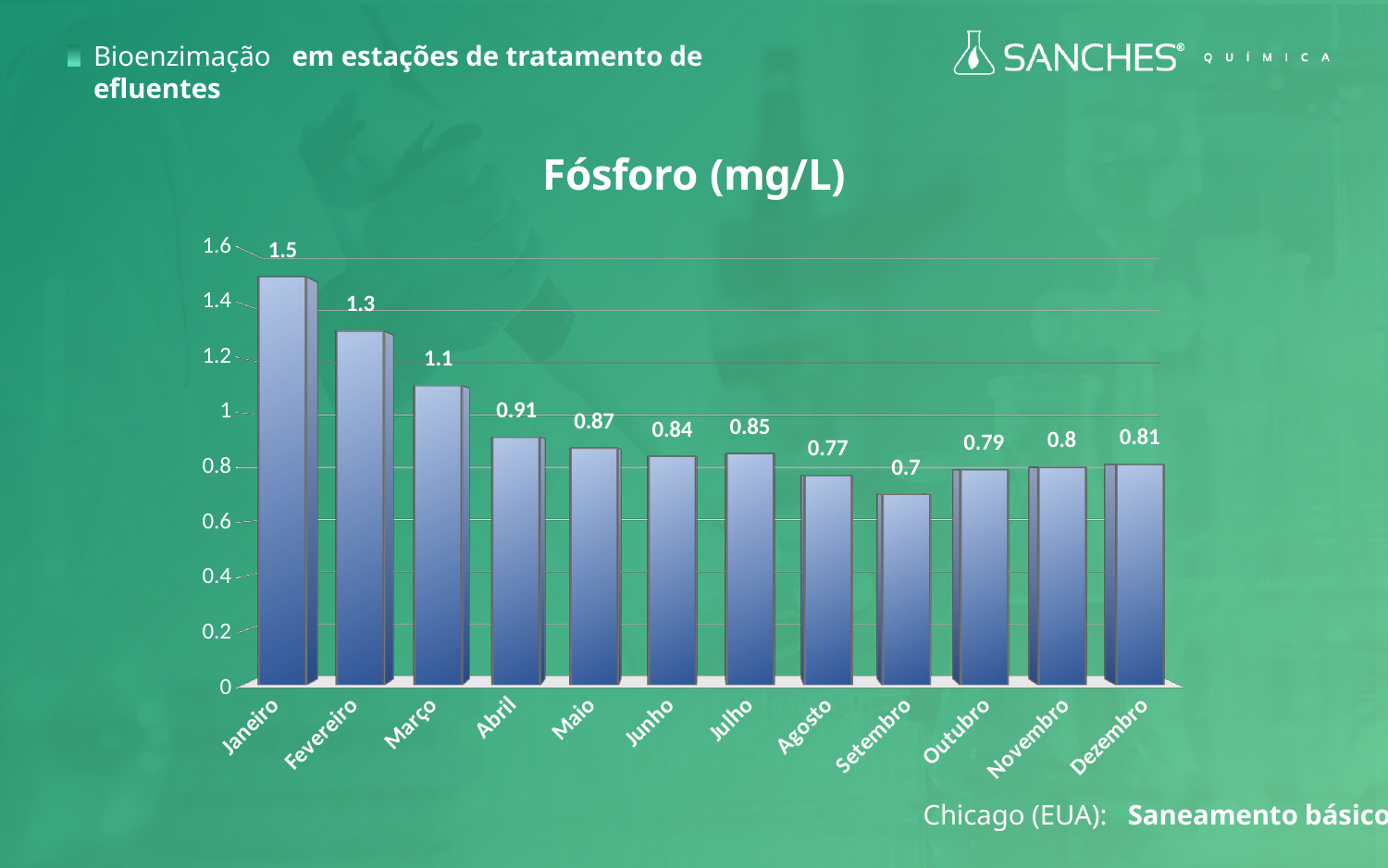
Which month has the highest value? Janeiro Which is larger, the value for Junho or the value for Julho? Julho What is the title of the chart? Fósforo (mg/L) What is the value for Janeiro? 1.5 What kind of chart is this? bar chart Which month has the lowest value? Setembro What is the value for Setembro? 0.7 What is the value for Abril? 0.91 How many months are shown on the x axis? 12 Is the value for Março greater or less than 1? greater Do the values rise or fall from Janeiro to Setembro? fall What is the difference between the values for Janeiro and Dezembro? 0.69